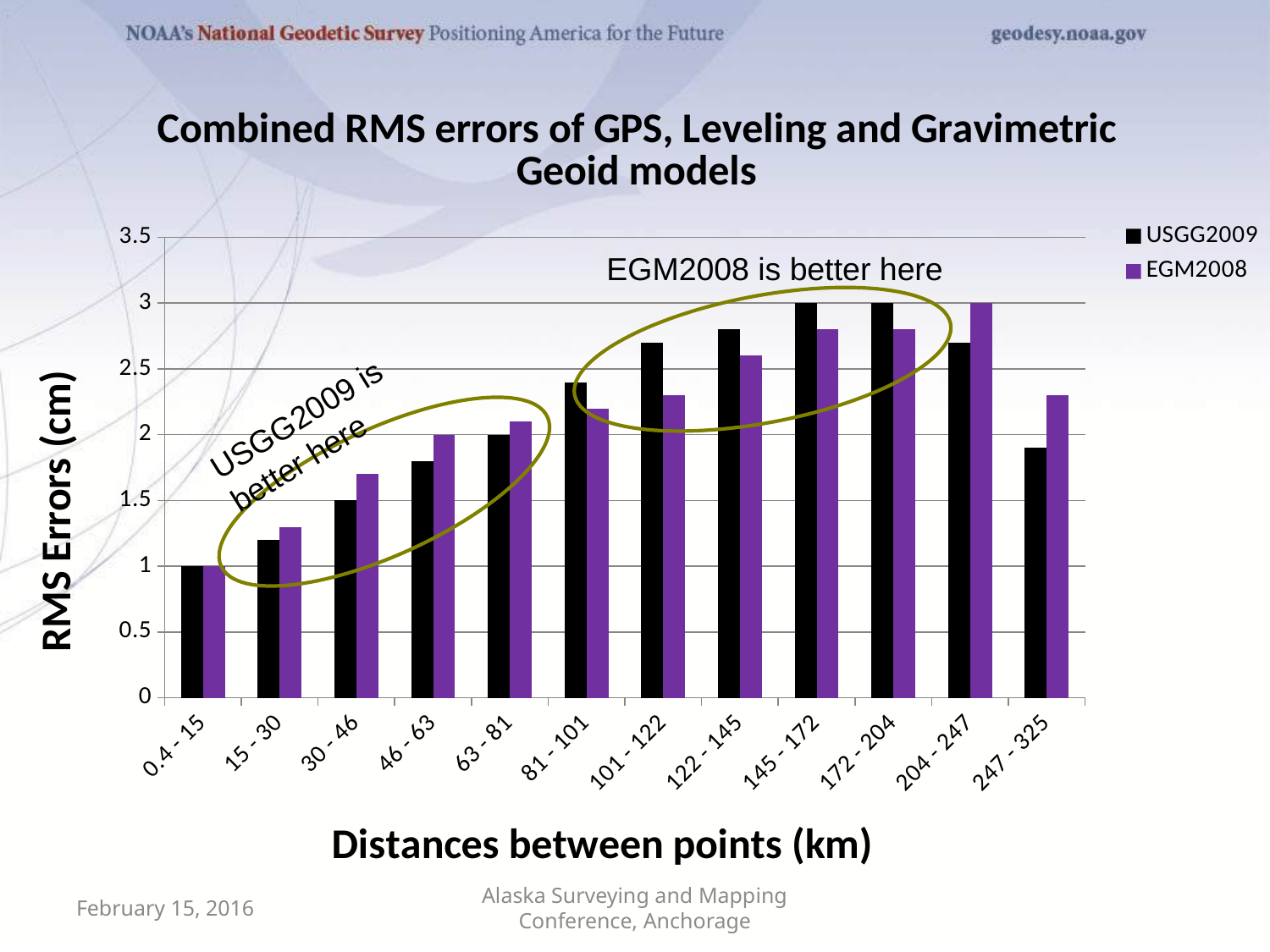
Is the EGM2008 value for the 247 - 325 km category greater or less than 2? greater Which distance category has the lowest USGG2009 RMS error? 0.4 - 15 What is the label of the y axis? RMS Errors (cm) What is the EGM2008 RMS error for the 46 - 63 km distance category? 2 For the 247 - 325 km category, which series has the larger RMS error, USGG2009 or EGM2008? EGM2008 How many series does the legend list? 2 What is the EGM2008 RMS error for the 204 - 247 km distance category? 3 What kind of chart is shown on the slide? bar chart What is the USGG2009 RMS error for the 30 - 46 km distance category? 1.5 Which distance category has the highest EGM2008 RMS error? 204 - 247 How many distance categories are shown on the x axis? 12 What is the USGG2009 RMS error for the 0.4 - 15 km distance category? 1